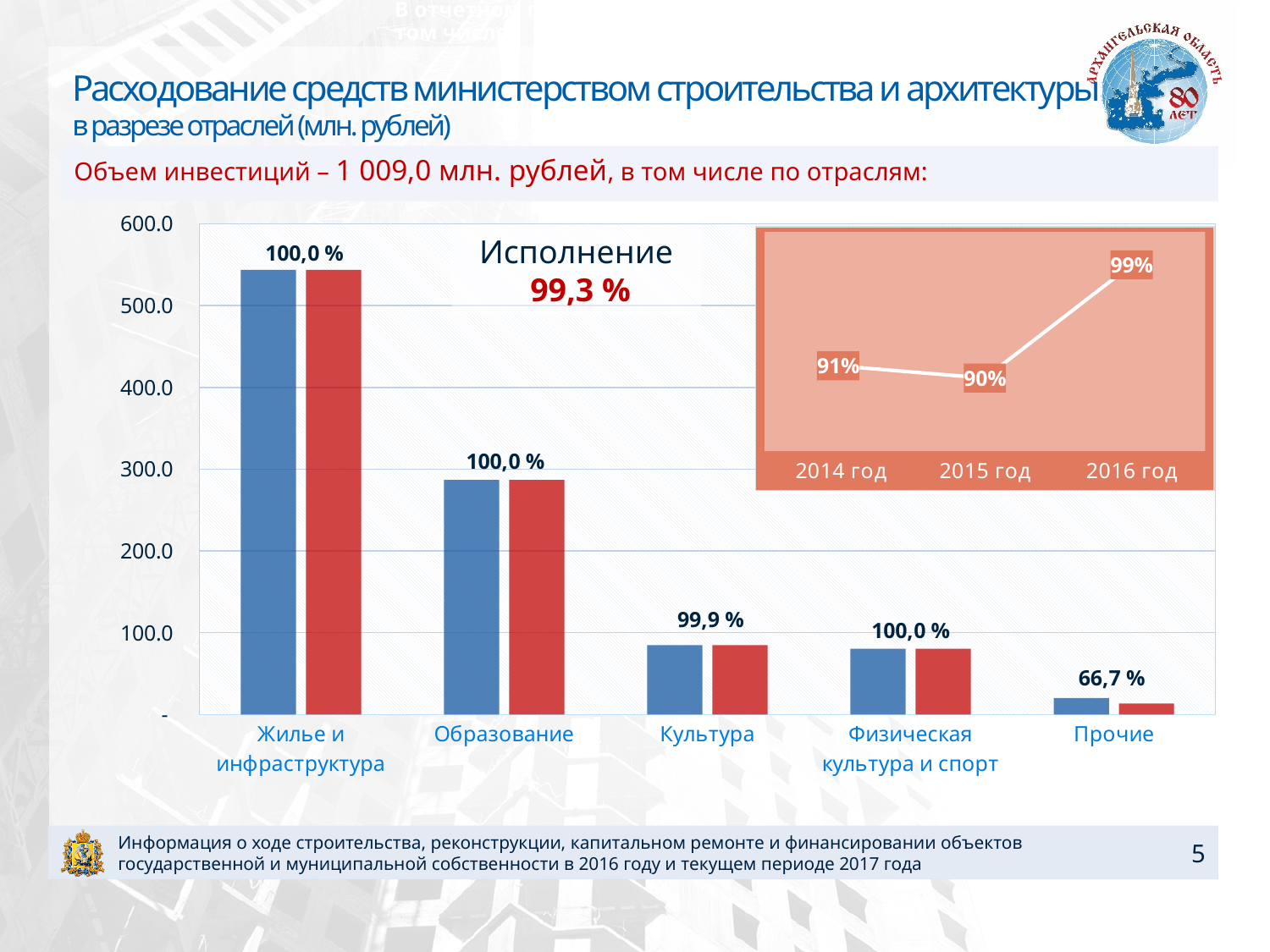
In the small line chart on the right, what is the difference between the values for 2016 год and 2015 год? 9% In the bar chart on the left, how many categories are shown on the x axis? 5 In the bar chart on the left, which category has the shortest bars? Прочие In the bar chart on the left, what percentage label is printed above the bars for Прочие? 66,7 % In the bar chart on the left, is the value for Культура greater or less than 100? less In the bar chart on the left, what percentage label is printed above the bars for Культура? 99,9 % In the bar chart on the left, which category has the tallest bars? Жилье и инфраструктура In the small line chart on the right, what is the value for 2015 год? 90% What kind of chart is the large chart on the left of the slide? bar chart In the bar chart on the left, which category has larger bars, Образование or Культура? Образование In the bar chart on the left, is the value for Жилье и инфраструктура greater or less than 500? greater In the small line chart on the right, which year has the highest value? 2016 год